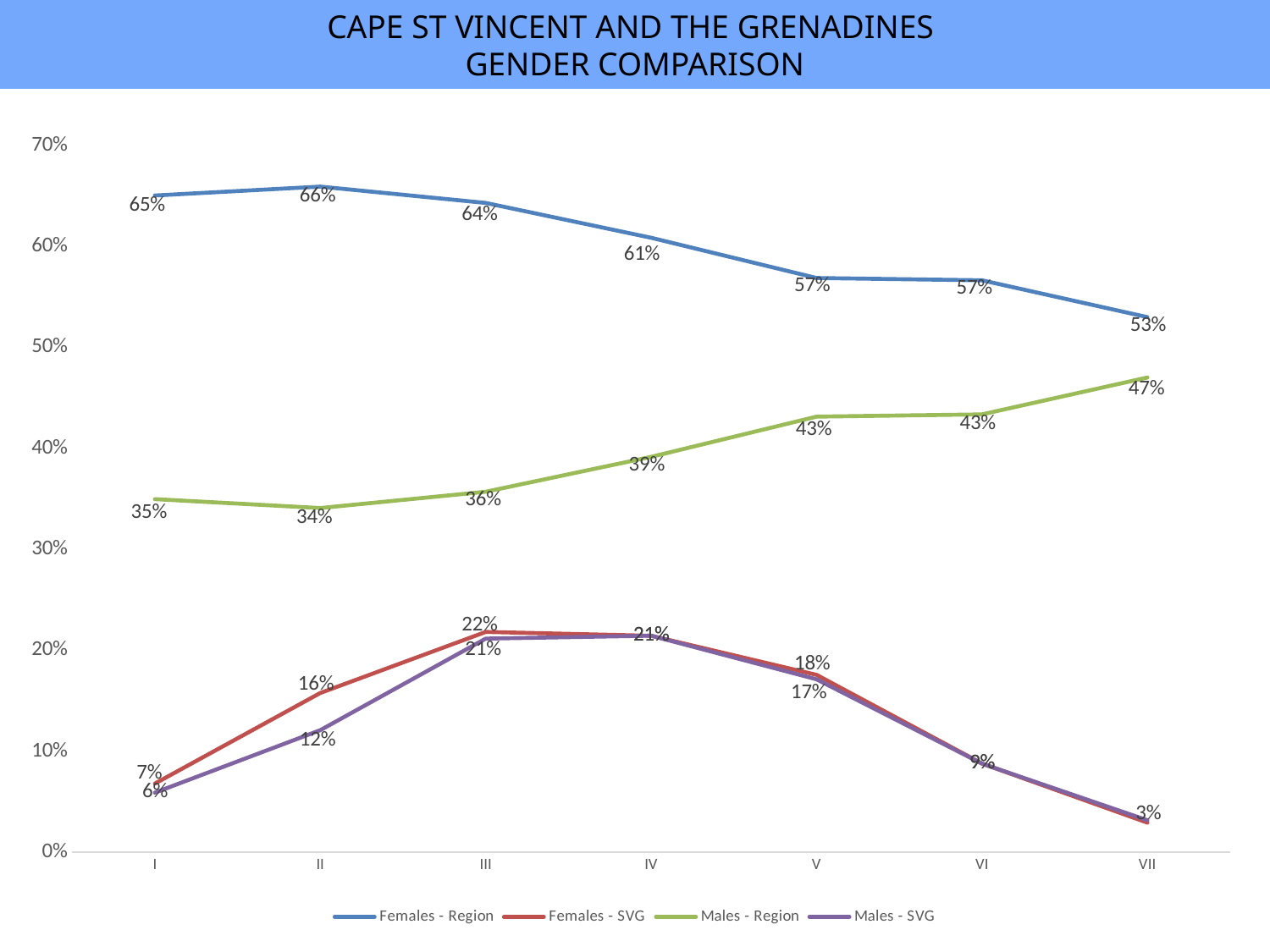
What is the value for Females - Region at category II? 66% How many series does the legend list? 4 At which category is Males - Region lowest? II How many categories are shown on the x axis? 7 What is the difference between Females - Region and Males - Region at category I? 30% What is the value for Males - SVG at category II? 12% What is the value for Females - SVG at category III? 22% Which is larger at category V: Females - SVG or Males - SVG? Females - SVG Does the Males - Region series generally rise or fall from category I to category VII? rise At which category is Females - Region highest? II What is the value for Males - Region at category VII? 47% What kind of chart is shown on the slide? line chart